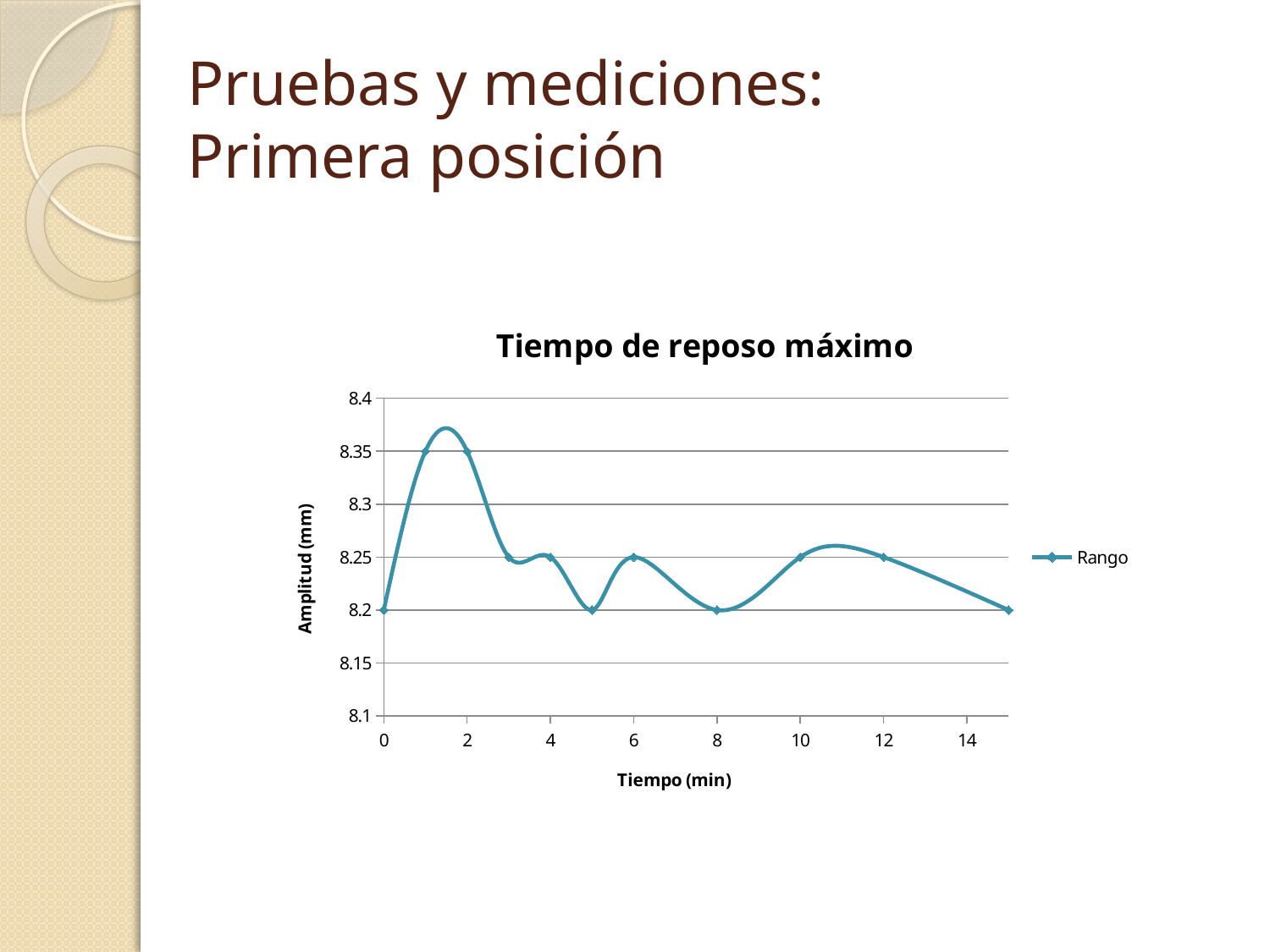
How many series does the legend list? 1 What is the amplitude value at time 6 min? 8.25 What is the title of the chart? Tiempo de reposo máximo Is the value at 2 min greater or less than 8.3? greater What kind of chart is shown on the slide? line chart What is the amplitude value at time 1 min? 8.35 What is the difference between the value at 2 min and the value at 8 min? 0.15 What is the amplitude value at time 0 min? 8.2 Which is larger, the value at 1 min or the value at 5 min? 1 min What is the name of the series shown in the legend? Rango Does the line rise or fall between 12 min and 15 min? fall How many data points are plotted on the line? 11